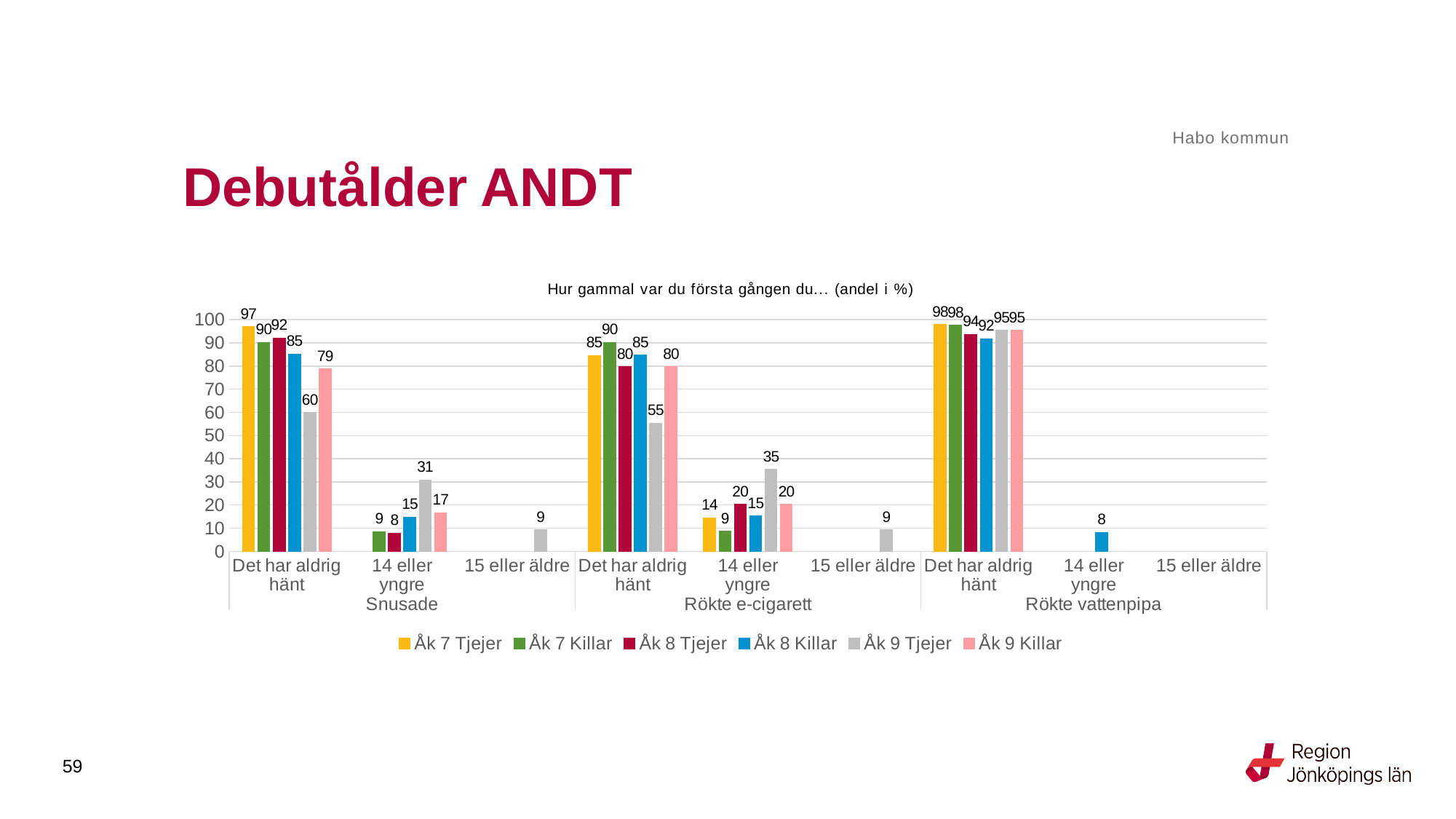
What is the title of the chart? Hur gammal var du första gången du… (andel i %) Is the value for Åk 9 Killar under "Det har aldrig hänt" in the Snusade group greater or less than 70? greater Which series has the highest value under "Det har aldrig hänt" in the Snusade group? Åk 7 Tjejer What is the value for Åk 9 Tjejer under "14 eller yngre" in the Rökte e-cigarett group? 35 What kind of chart is shown on the slide? bar chart Which series has the lowest value under "Det har aldrig hänt" in the Rökte e-cigarett group? Åk 9 Tjejer How many series does the legend list? 6 What is the value for Åk 8 Tjejer under "14 eller yngre" in the Rökte e-cigarett group? 20 What is the value for Åk 9 Tjejer under "Det har aldrig hänt" in the Snusade group? 60 What is the difference between Åk 7 Tjejer and Åk 9 Tjejer under "Det har aldrig hänt" in the Snusade group? 37 Which is larger under "14 eller yngre" in the Snusade group: Åk 9 Tjejer or Åk 9 Killar? Åk 9 Tjejer What is the value for Åk 8 Killar under "14 eller yngre" in the Rökte vattenpipa group? 8